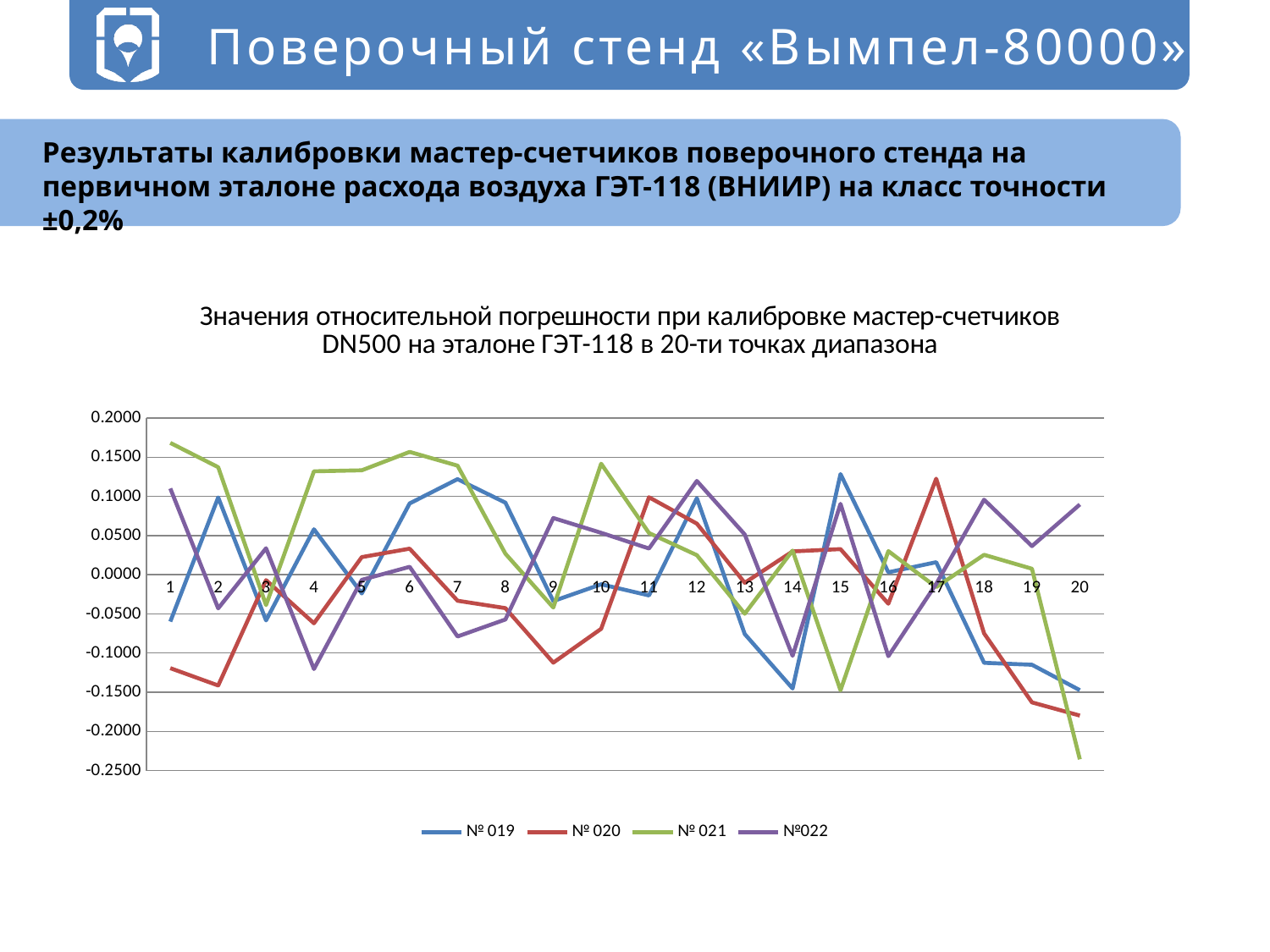
Is the value for № 021 at point 20 greater or less than -0.2000? less Which series has the lowest value at point 20? № 021 Is the value for № 020 at point 1 greater or less than -0.1000? less How many series does the legend list? 4 Which series has the highest value at point 1? № 021 Which series are listed in the legend? № 019, № 020, № 021, №022 Is the value for № 019 at point 15 greater or less than 0.1000? greater At point 15, which series has the larger value, № 019 or № 021? № 019 What is the title of the chart? Значения относительной погрешности при калибровке мастер-счетчиков DN500 на эталоне ГЭТ-118 в 20-ти точках диапазона How many points are plotted along the x axis for each series? 20 What kind of chart is shown on the slide? line chart